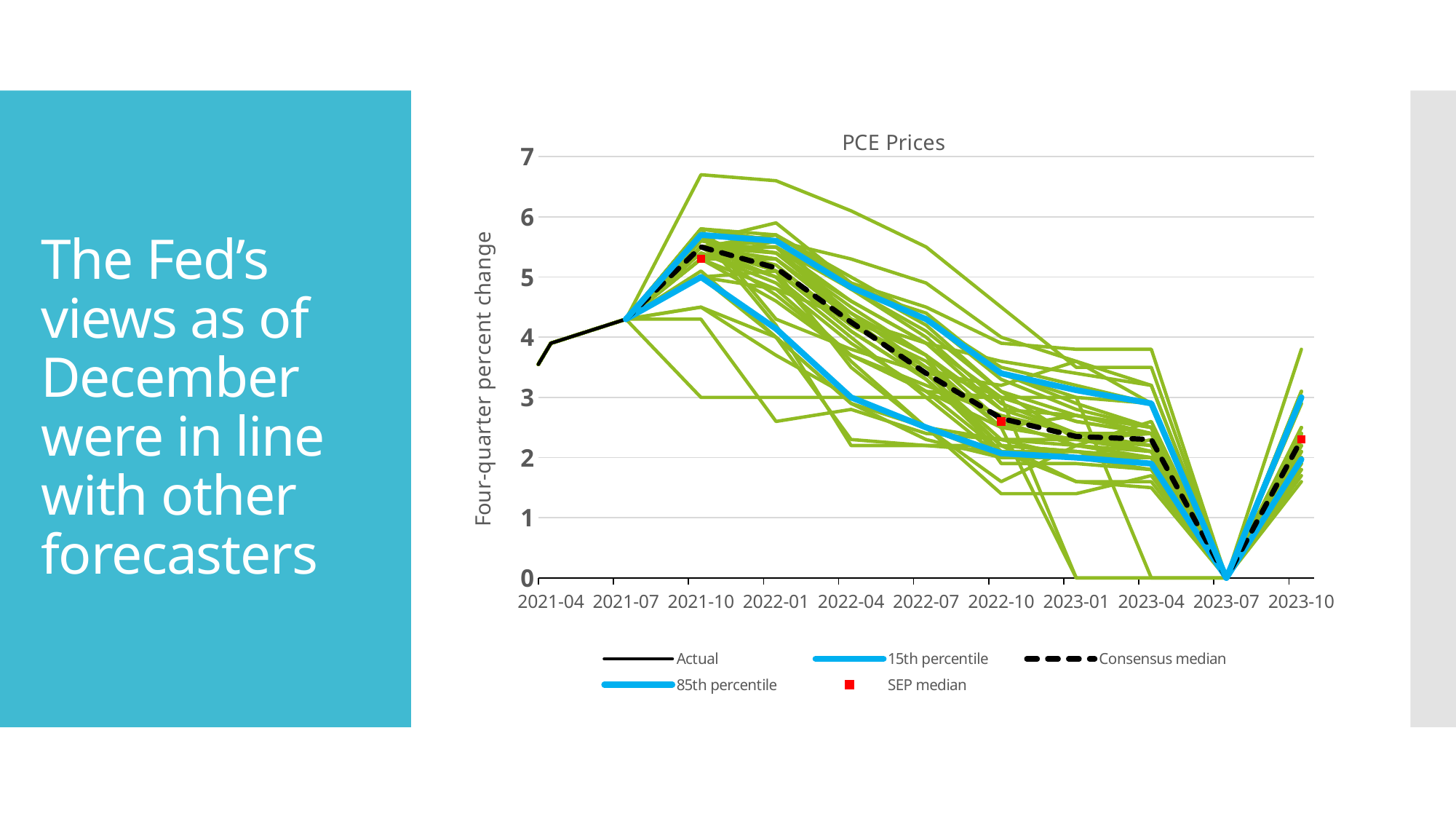
How many date labels are shown along the x axis of the chart? 11 Does the Consensus median line rise or fall between 2021-10 and 2023-04? fall What is the label of the vertical axis? Four-quarter percent change What kind of chart is shown on the slide? line chart Is the 85th percentile value at 2022-07 greater or less than 4? greater What is the title of the chart? PCE Prices Is the SEP median value at 2022-10 greater or less than 3? less At which x-axis date does the Consensus median reach its lowest value? 2023-07 At 2022-10, which is larger: the 85th percentile or the SEP median? 85th percentile How many series does the chart's legend list? 5 Is the 15th percentile value at 2022-07 greater or less than 3? less